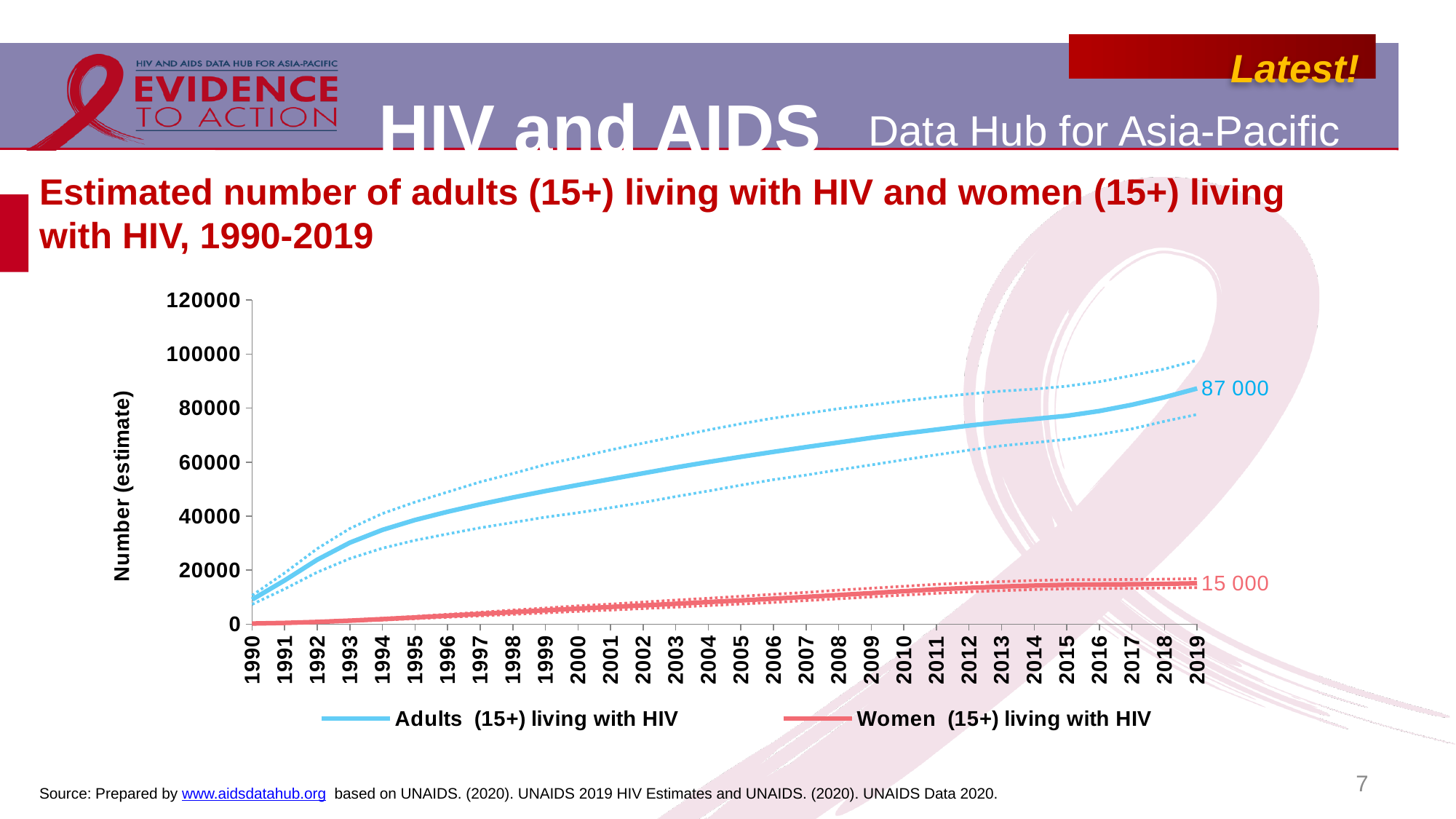
What is the label of the y-axis? Number (estimate) Is the value for adults (15+) living with HIV in 1990 greater or less than 20000? less What colour is the line for women (15+) living with HIV? Red What is the estimated number of women (15+) living with HIV in 2019? 15 000 Is the value for adults (15+) living with HIV in 2000 greater or less than 40000? greater Which series has the larger value in 2019, adults (15+) living with HIV or women (15+) living with HIV? Adults (15+) living with HIV Does the number of adults (15+) living with HIV rise or fall from 1990 to 2019? Rise What is the difference between the 2019 values for adults (15+) living with HIV and women (15+) living with HIV? 72 000 What kind of chart is shown on the slide? Line chart How many series does the legend list? 2 What is the estimated number of adults (15+) living with HIV in 2019? 87 000 Is the value for women (15+) living with HIV in 2010 greater or less than 20000? less